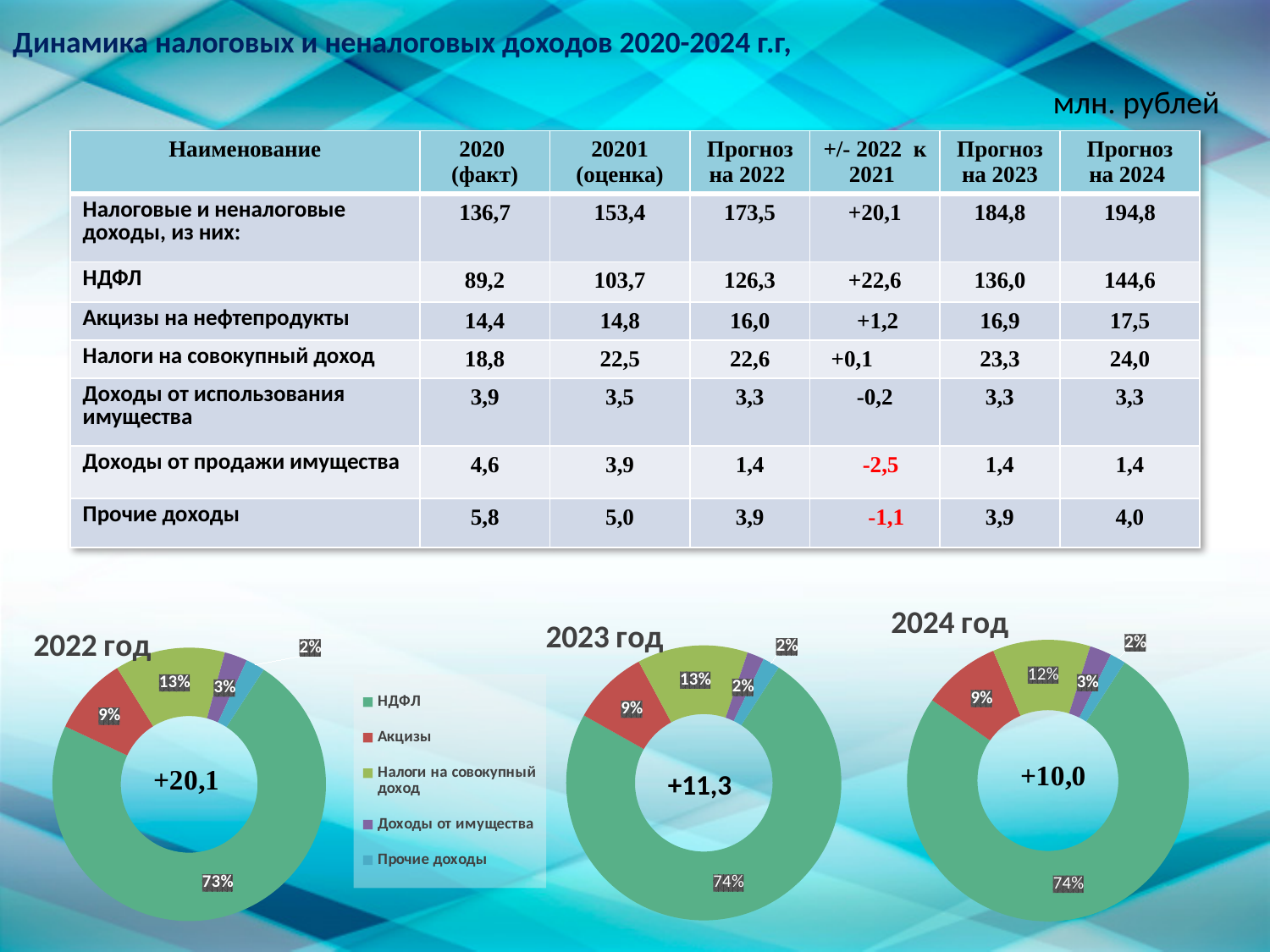
What kind of chart is the 2023 год chart? Doughnut chart In the 2022 год chart, what share does НДФЛ have? 73% How many series does the legend list for the doughnut charts? 5 In the 2023 год chart, which is larger: the share of Акцизы or the share of Налоги на совокупный доход? Налоги на совокупный доход In the 2022 год chart, what share does Акцизы have? 9% In the 2022 год chart, which category has the largest share? НДФЛ What value is printed in the centre of the 2024 год chart? +10,0 In the 2024 год chart, what share does Налоги на совокупный доход have? 12% What value is printed in the centre of the 2022 год chart? +20,1 In the 2022 год chart, what is the difference between the share of Налоги на совокупный доход and the share of Акцизы? 4% In the 2024 год chart, which category has the smallest share? Прочие доходы